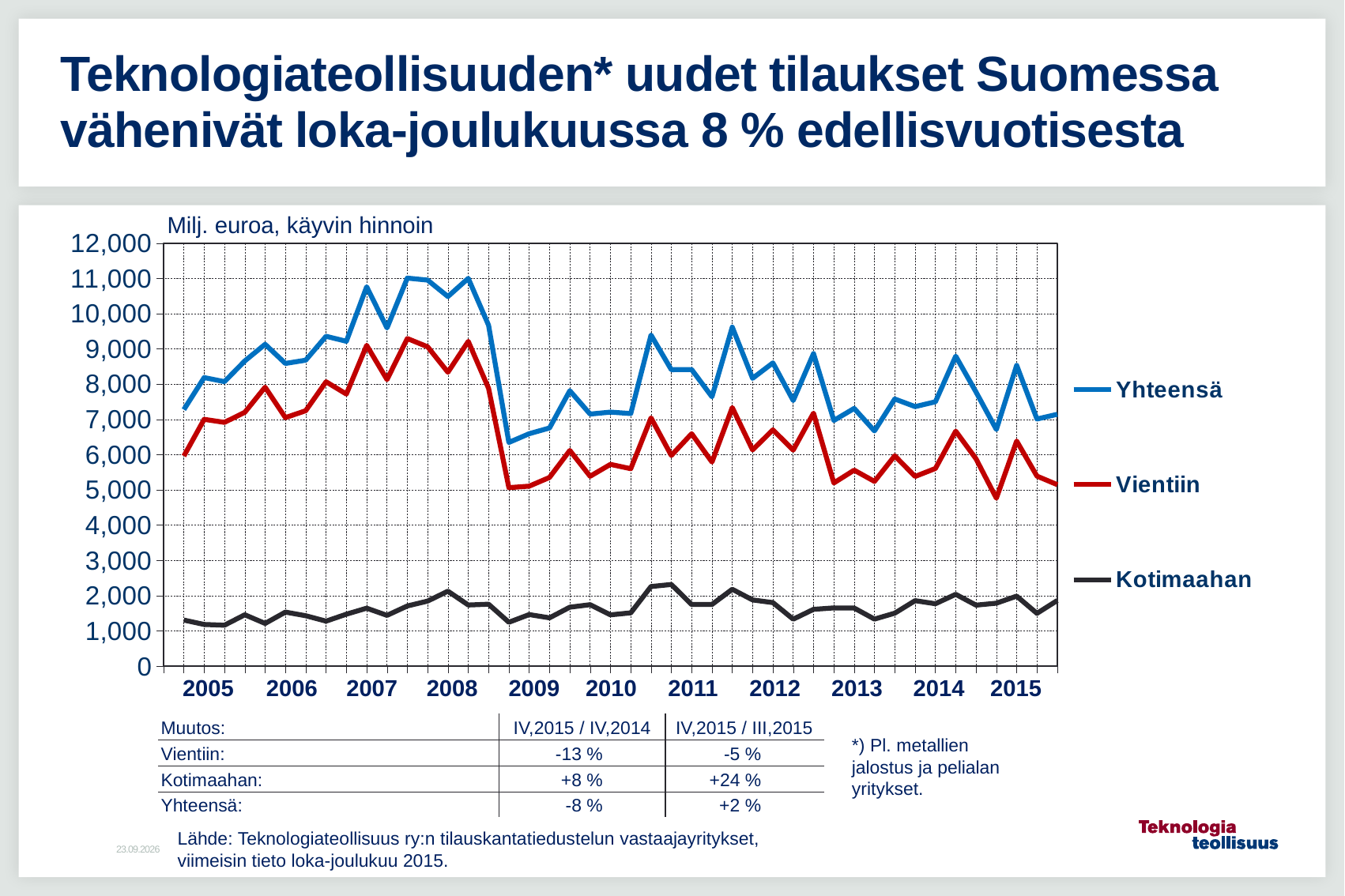
Is the Kotimaahan series ever greater or less than 3,000 over the whole period? less What colour is the Vientiin line in the chart? red Does the Yhteensä series rise or fall between 2008 and 2009? fall Is the value of the Vientiin series at the start of 2009 greater or less than 6,000? less Which series has the highest values throughout the chart? Yhteensä What kind of chart is shown on the slide? line chart How many series does the chart's legend list? 3 Is the peak value of the Yhteensä series around 2007–2008 greater or less than 10,000? greater What unit label is shown above the chart's y axis? Milj. euroa, käyvin hinnoin Which series has the lowest values throughout the chart? Kotimaahan Which series is larger in 2012, Vientiin or Kotimaahan? Vientiin How many years are labelled on the x axis of the chart? 11